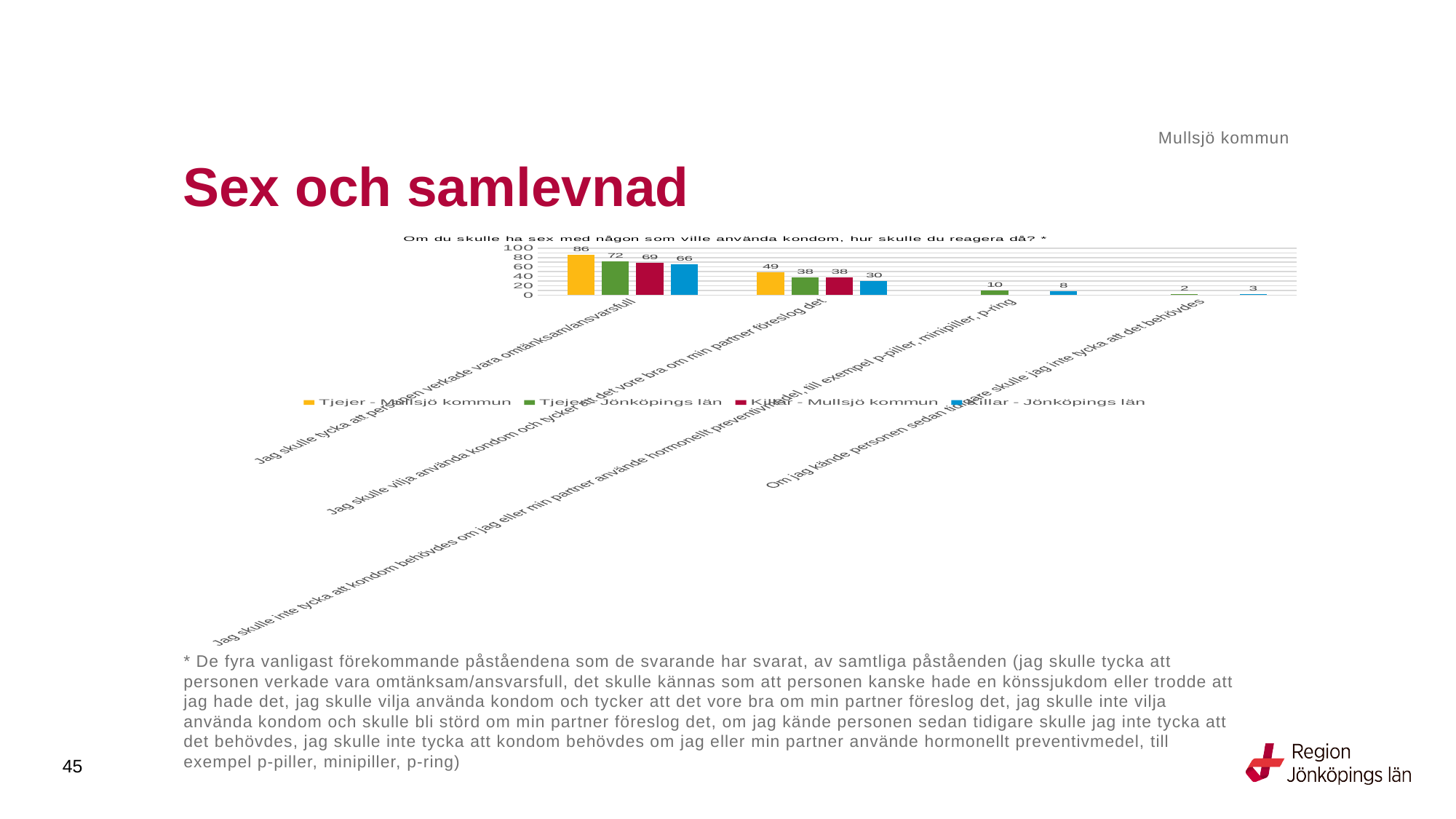
How many series does the legend list? 4 What value is shown for Killar - Jönköpings län for "Jag skulle vilja använda kondom och tycker att det vore bra om min partner föreslog det"? 30 Which series has the lowest value for "Jag skulle vilja använda kondom och tycker att det vore bra om min partner föreslog det"? Killar - Jönköpings län Is the value for Tjejer - Jönköpings län for "Jag skulle tycka att personen verkade vara omtänksam/ansvarsfull" greater or less than 60? greater What colour represents Killar - Mullsjö kommun in the chart? Red What value is shown for Tjejer - Jönköpings län for "Jag skulle inte tycka att kondom behövdes om jag eller min partner använde hormonellt preventivmedel, till exempel p-piller, minipiller, p-ring"? 10 Which series has the highest value for "Jag skulle tycka att personen verkade vara omtänksam/ansvarsfull"? Tjejer - Mullsjö kommun What kind of chart is shown on the slide? Bar chart What value is shown for Killar - Jönköpings län for "Om jag kände personen sedan tidigare skulle jag inte tycka att det behövdes"? 3 What is the difference between Tjejer - Mullsjö kommun and Killar - Mullsjö kommun for "Jag skulle tycka att personen verkade vara omtänksam/ansvarsfull"? 17 What value is shown for Tjejer - Mullsjö kommun for "Jag skulle tycka att personen verkade vara omtänksam/ansvarsfull"? 86 Which is larger for "Jag skulle inte tycka att kondom behövdes om jag eller min partner använde hormonellt preventivmedel, till exempel p-piller, minipiller, p-ring": Tjejer - Jönköpings län or Killar - Jönköpings län? Tjejer - Jönköpings län